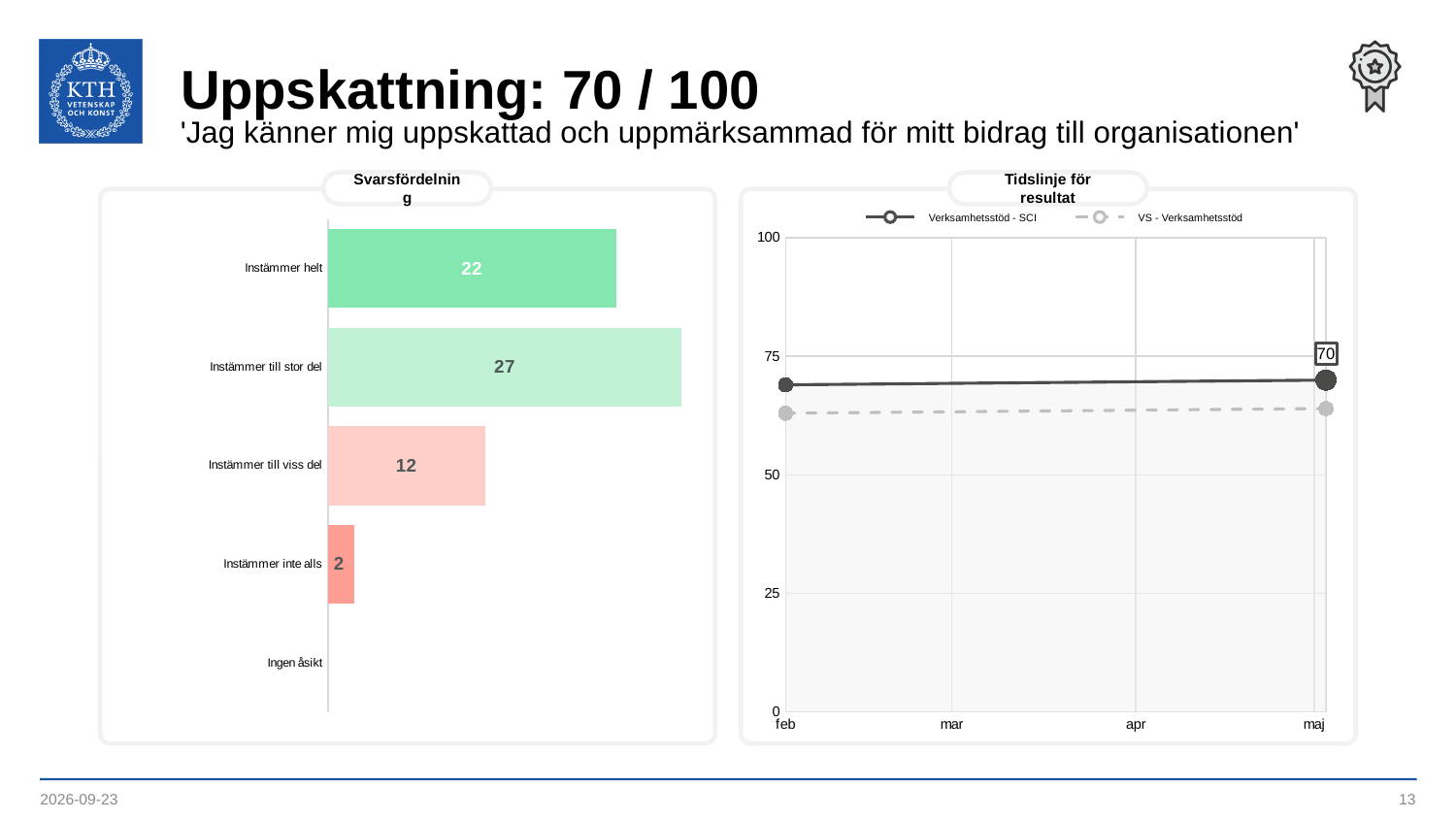
In the 'Svarsfördelning' chart, which category has the highest value? Instämmer till stor del In the 'Svarsfördelning' chart, what is the difference between 'Instämmer till stor del' and 'Instämmer till viss del'? 15 In the 'Svarsfördelning' chart, what is the value for 'Instämmer helt'? 22 What kind of chart is the 'Svarsfördelning' chart? Bar chart In the 'Svarsfördelning' chart, how many categories are listed on the axis? 5 In the 'Svarsfördelning' chart, what is the value for 'Instämmer till stor del'? 27 In the 'Svarsfördelning' chart, which is larger: 'Instämmer helt' or 'Instämmer till viss del'? Instämmer helt In the 'Tidslinje för resultat' chart, how many series does the legend list? 2 In the 'Tidslinje för resultat' chart, what is the value for 'Verksamhetsstöd - SCI' in maj? 70 What kind of chart is the 'Tidslinje för resultat' chart? Line chart In the 'Tidslinje för resultat' chart, is the value for 'VS - Verksamhetsstöd' in feb greater or less than 75? less In the 'Svarsfördelning' chart, what is the value for 'Instämmer inte alls'? 2